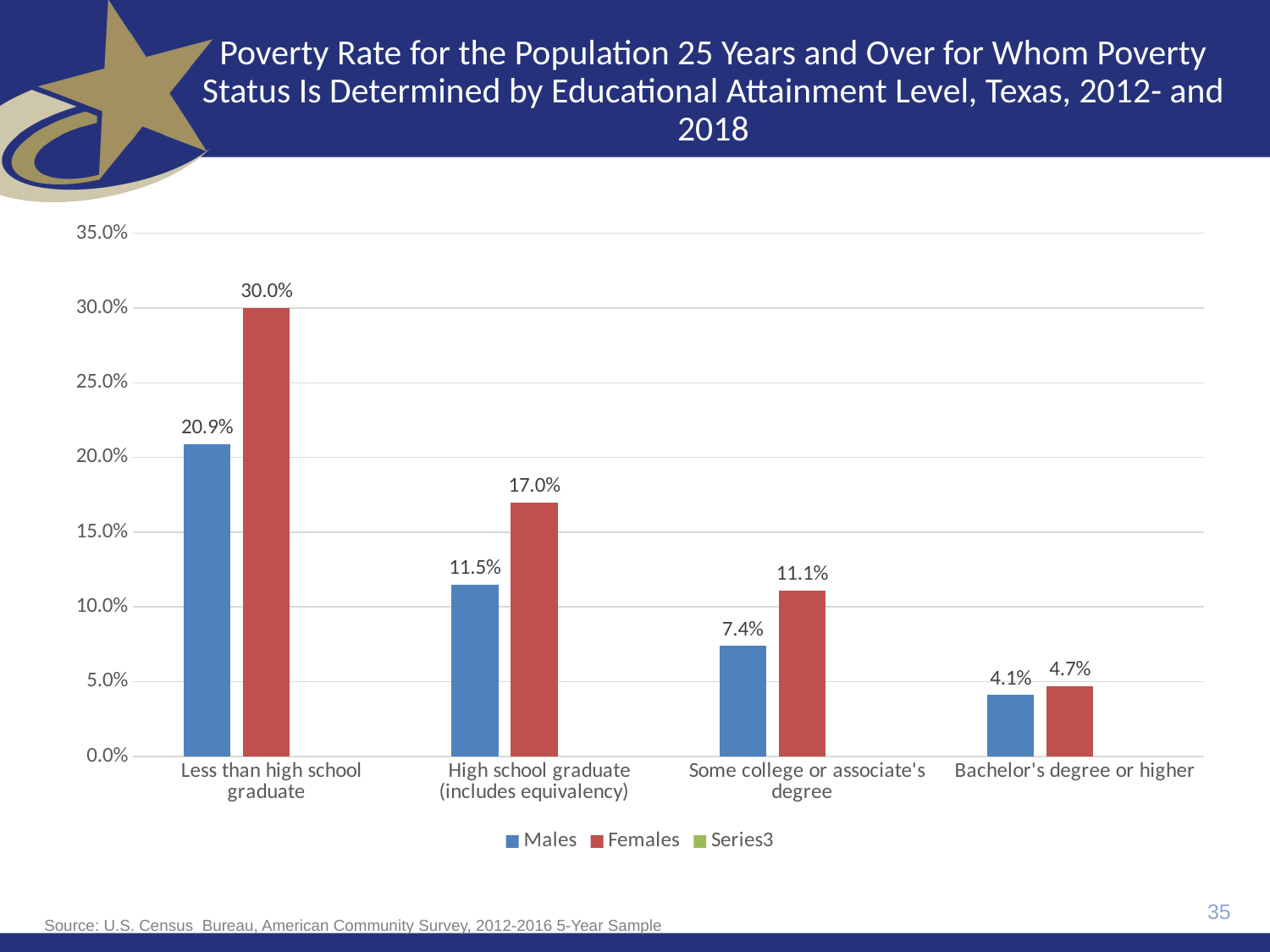
Which is larger, the Male or Female poverty rate for high school graduates (includes equivalency)? Females Which educational attainment level has the lowest poverty rate for Males? Bachelor's degree or higher Which educational attainment level has the highest poverty rate for Females? Less than high school graduate Do the Male poverty rates rise or fall as educational attainment increases from left to right? Fall How many series does the legend list? 3 What is the poverty rate for Females with a bachelor's degree or higher? 4.7% What is the poverty rate for Males with less than a high school graduate education? 20.9% What kind of chart is shown on the slide? Bar chart What is the poverty rate for Males with some college or associate's degree? 7.4% What is the difference between the Female and Male poverty rates for those with less than a high school graduate education? 9.1% How many educational attainment categories are shown on the x axis? 4 What is the poverty rate for Females who are high school graduates (includes equivalency)? 17.0%